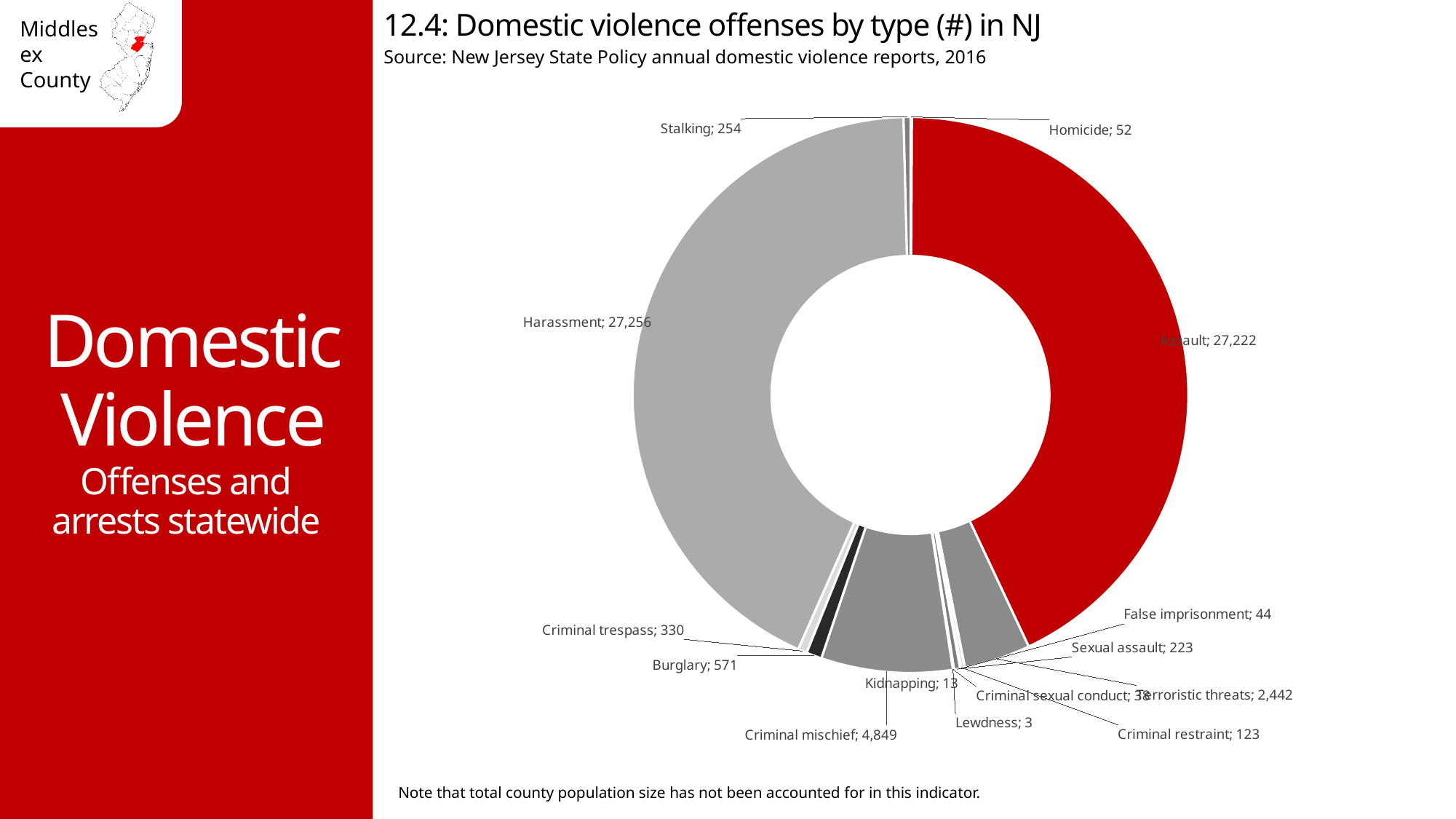
What is the value for Assault? 27,222 What is the value for Terroristic threats? 2,442 What is the difference between Criminal mischief and Terroristic threats? 2,407 What is the title of the chart? 12.4: Domestic violence offenses by type (#) in NJ What is the difference between Harassment and Assault? 34 What is the value for Homicide? 52 What is the value for Criminal mischief? 4,849 Which offense type has the lowest value? Lewdness Which is larger, Burglary or Criminal trespass? Burglary How many offense types are shown in the chart? 14 What kind of chart is shown? doughnut chart What is the value for Harassment? 27,256